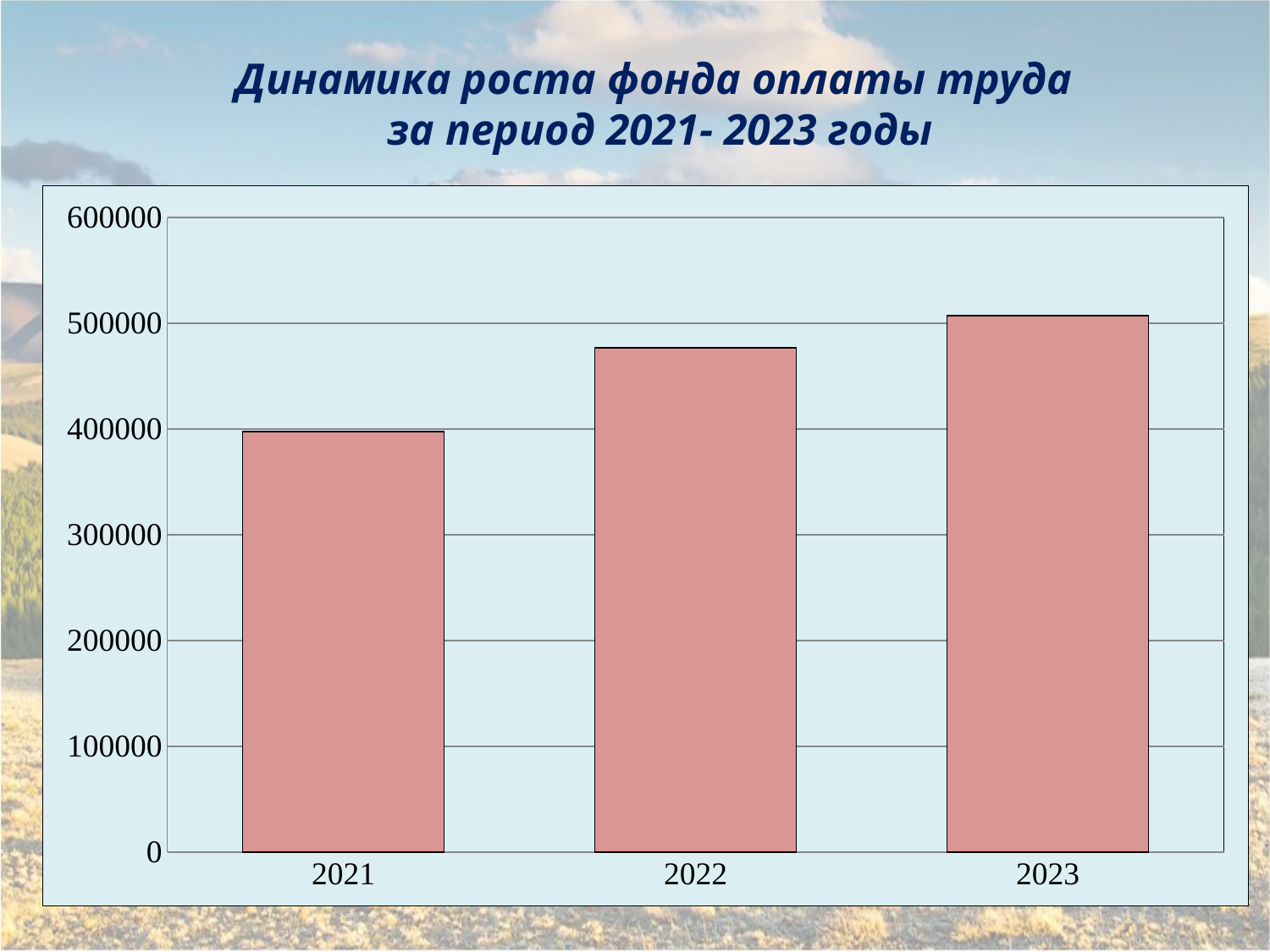
What kind of chart is shown on the slide? bar chart What is the highest value shown on the vertical axis? 600000 Which year has the lowest value in the chart? 2021 Is the value for 2021 greater or less than 300000? greater Is the value for 2022 greater or less than 500000? less Is the value for 2022 greater or less than 400000? greater How many bars (years) are shown in the chart? 3 Which is larger, the value for 2021 or the value for 2022? 2022 What is the title of the slide? Динамика роста фонда оплаты труда за период 2021- 2023 годы Do the values rise or fall from 2021 to 2023? rise Which year has the highest value in the chart? 2023